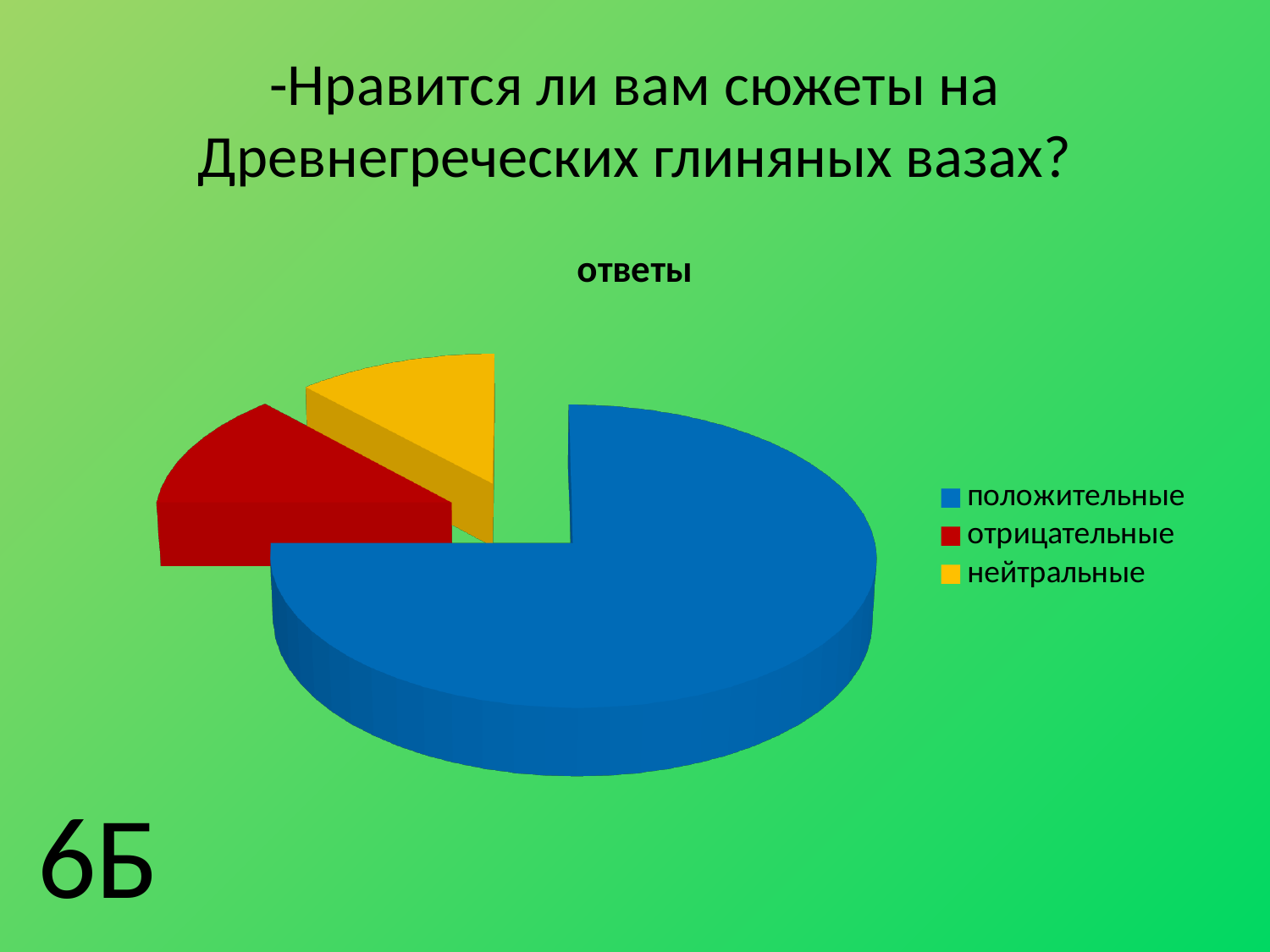
How many slices does the pie chart have? 3 What is the title of the chart? ответы Which category has the largest slice of the pie? положительные What colour is the slice for положительные? blue How many entries does the chart legend list? 3 What kind of chart is shown on the slide? pie chart Which slice is larger, положительные or отрицательные? положительные Does the slice for положительные take up more or less than half of the pie? more